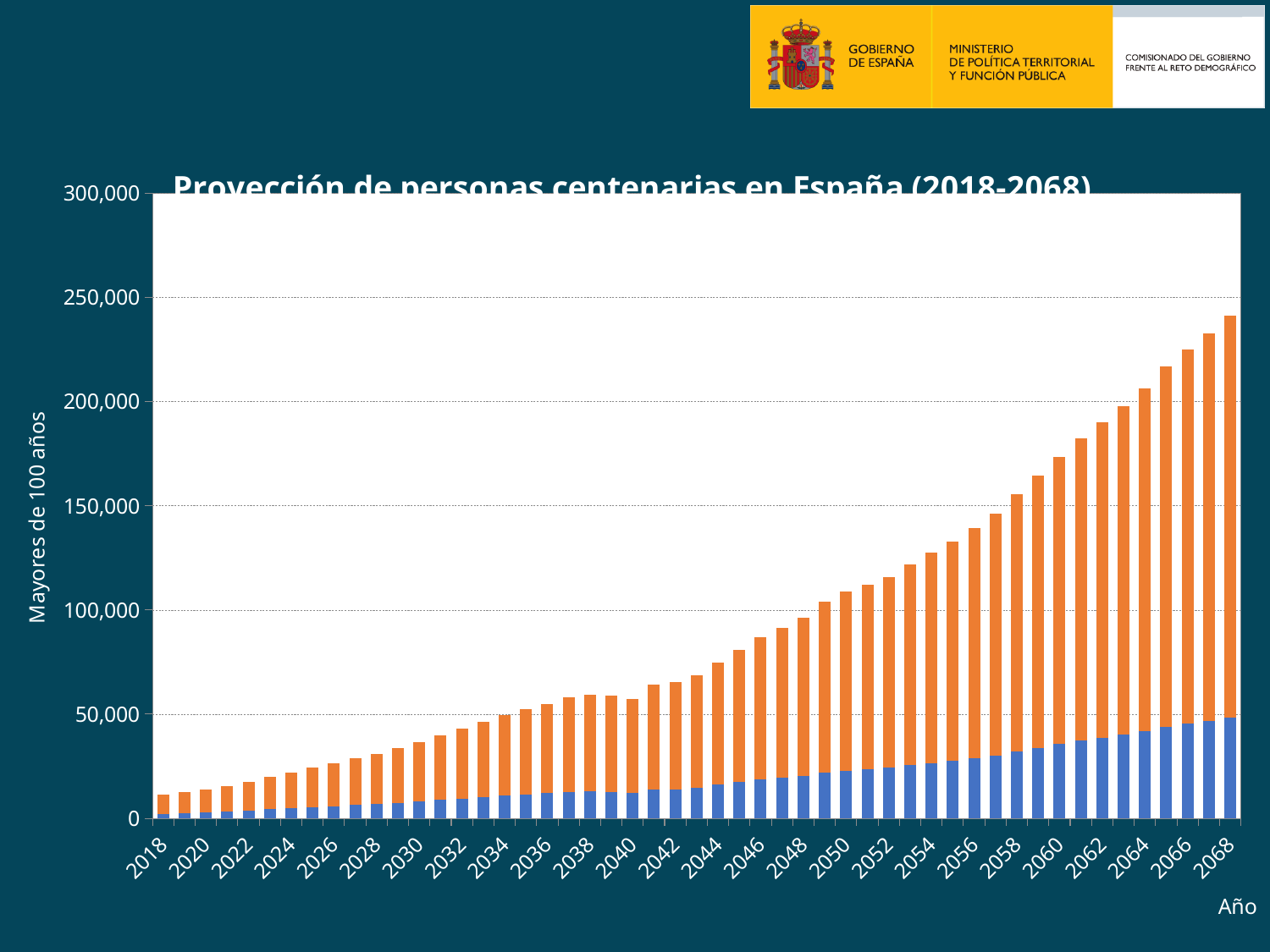
What is the title of the chart? Proyección de personas centenarias en España (2018-2068) Do the bar heights generally rise or fall from 2018 to 2068? rise Is the total value for 2018 greater or less than 50,000? less Is the total value for 2040 greater or less than 100,000? less Is the total value for 2068 greater or less than 200,000? greater Which year has the shortest bar? 2018 Which year has the tallest bar? 2068 Which year has the larger total bar, 2040 or 2060? 2060 How many year labels are shown on the x axis? 26 What is the label of the vertical axis? Mayores de 100 años What kind of chart is shown on the slide? bar chart